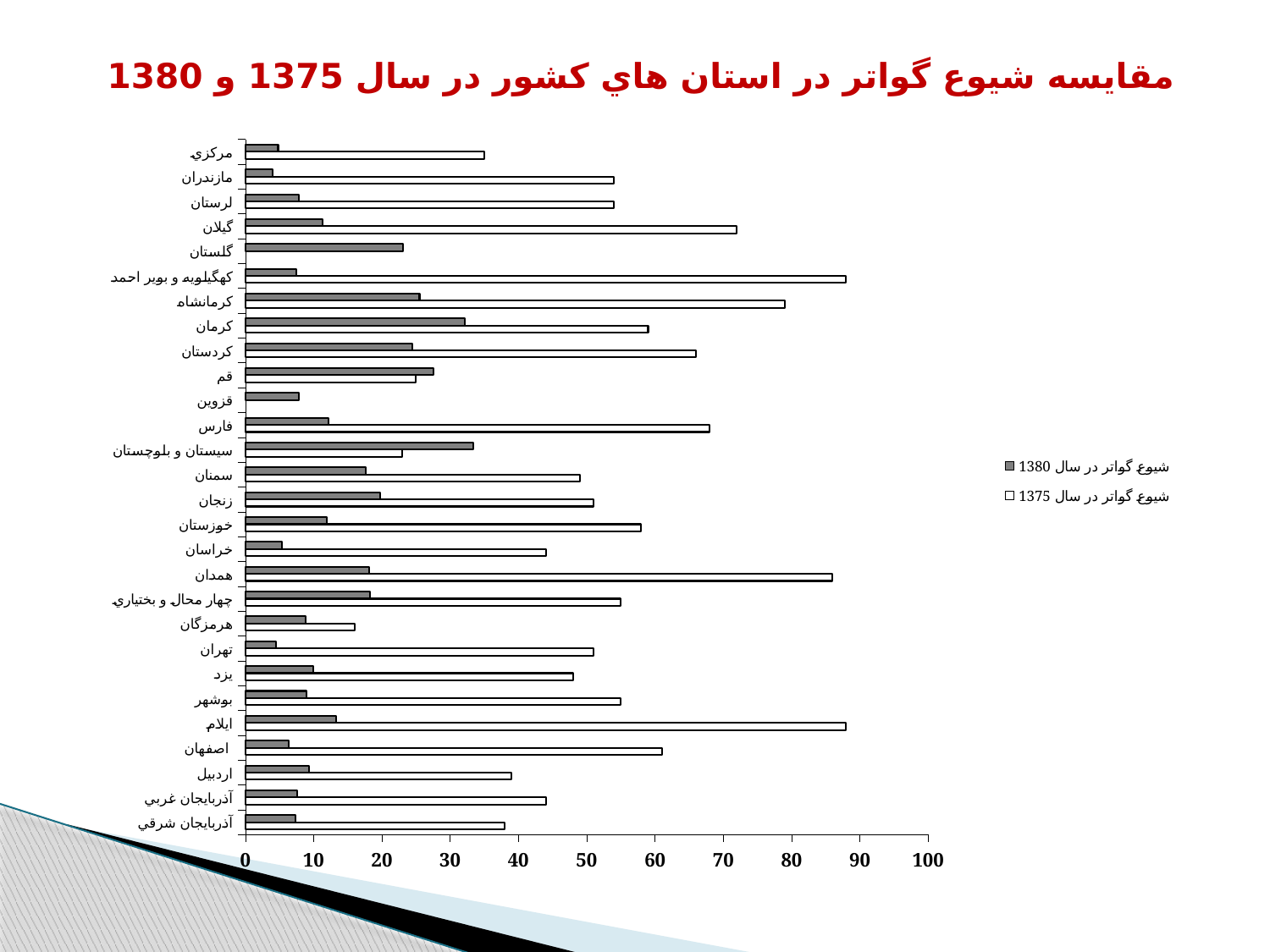
In the series شيوع گواتر در سال 1375, which has the larger value: گيلان or مازندران? گيلان For سيستان و بلوچستان, which series has the larger value: شيوع گواتر در سال 1380 or شيوع گواتر در سال 1375? شيوع گواتر در سال 1380 Is the value for مرکزي in the series شيوع گواتر در سال 1375 greater or less than 40? less What kind of chart is shown on the slide? bar chart Is the value for کرمانشاه in the series شيوع گواتر در سال 1375 greater or less than 70? greater Is the value for همدان in the series شيوع گواتر در سال 1375 greater or less than 80? greater How many provinces (categories) are shown on the chart? 28 Which series is drawn with the darker (gray) bars? شيوع گواتر در سال 1380 How many series does the legend list? 2